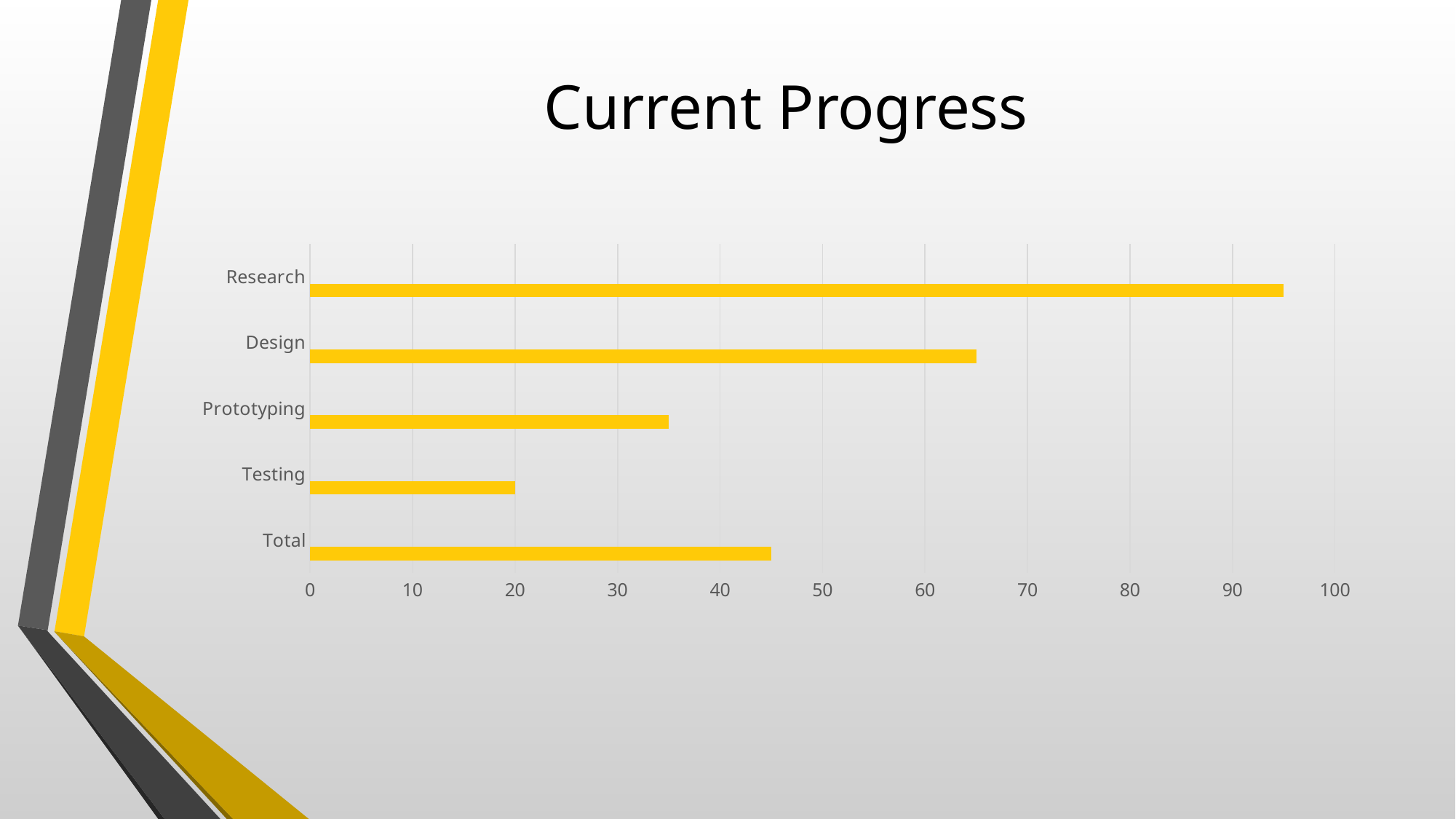
Which is larger, the value for Prototyping or the value for Testing? Prototyping Which category has the highest value? Research How many categories are shown in the chart? 5 Is the value for Prototyping greater or less than 40? less Which is larger, the value for Design or the value for Total? Design Is the value for Design greater or less than 60? greater Which category has the lowest value? Testing What is the title of the slide containing the chart? Current Progress Is the value for Total greater or less than 50? less What is the value for Testing? 20 What type of chart is shown on the slide? bar chart